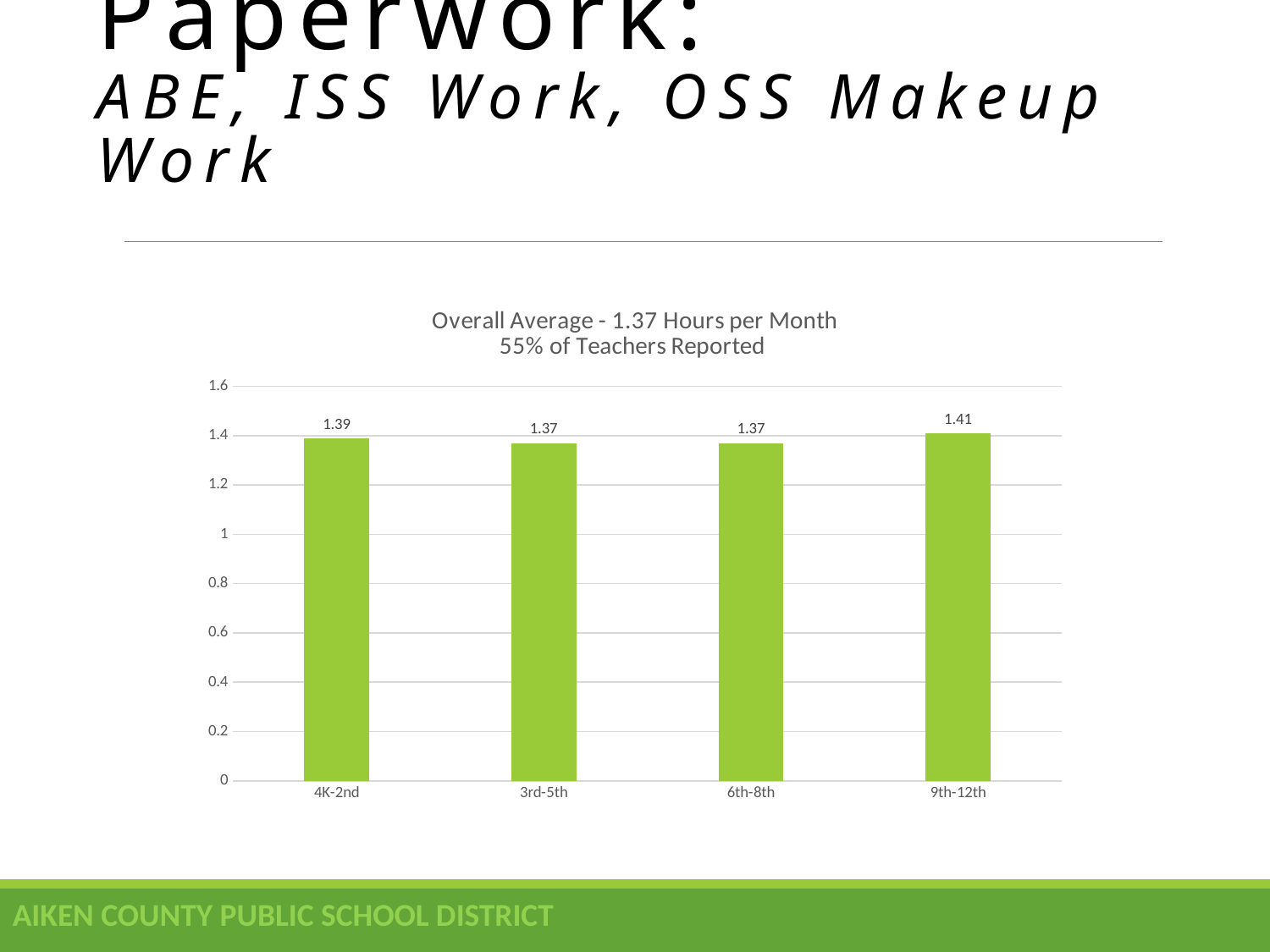
What is the value for 3rd-5th? 1.37 Which is larger, the value for 4K-2nd or the value for 3rd-5th? 4K-2nd Is the value for 6th-8th greater or less than 1.2? greater What is the value for 6th-8th? 1.37 What is the difference between the values for 9th-12th and 3rd-5th? 0.04 What is the difference between the values for 9th-12th and 4K-2nd? 0.02 How many grade bands are shown on the chart? 4 Which grade band has the highest value? 9th-12th What is the value for 9th-12th? 1.41 What kind of chart is shown on the slide? bar chart What overall average is stated in the chart title? 1.37 Hours per Month What is the value for 4K-2nd? 1.39